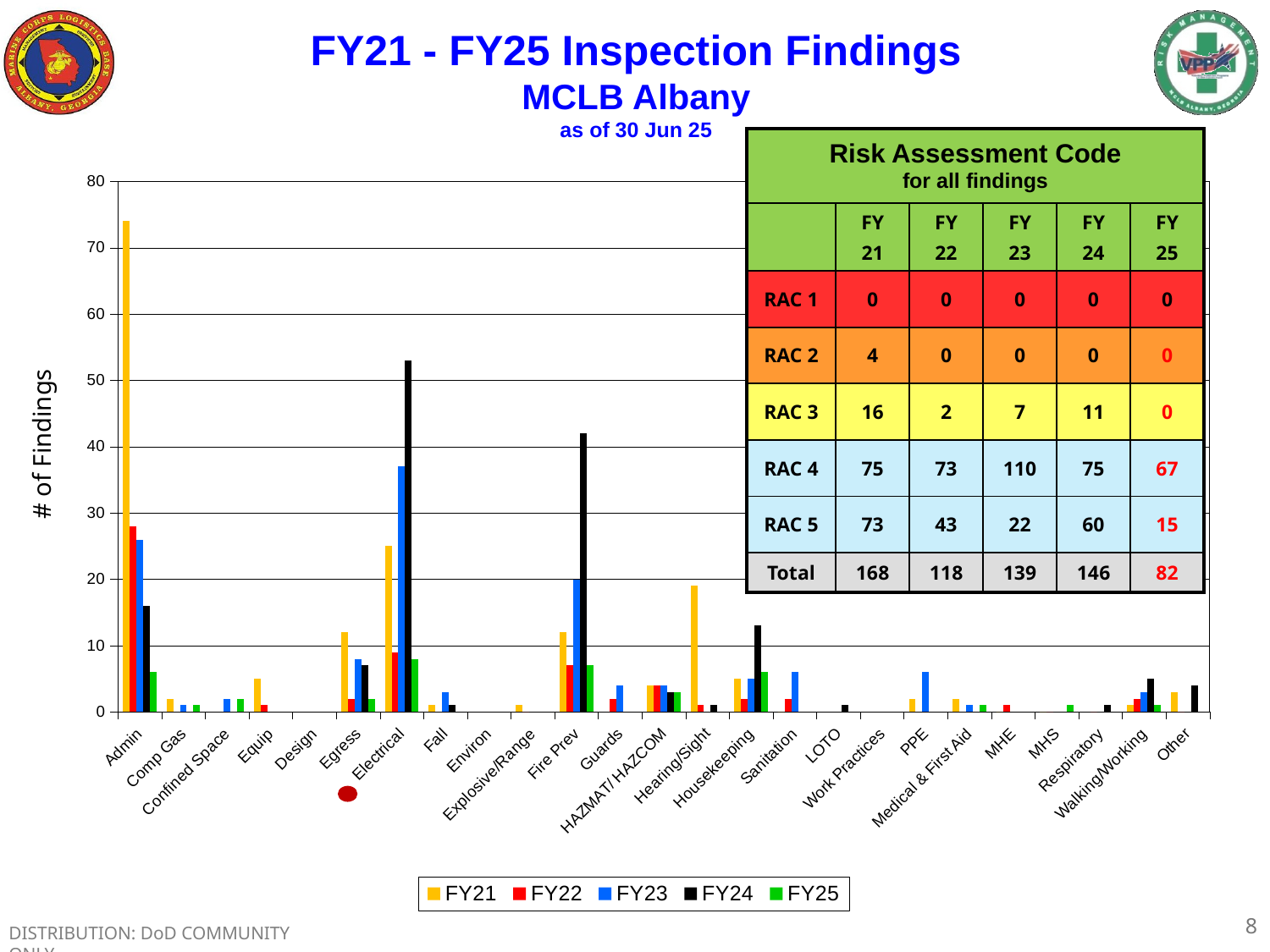
Which category has the highest FY24 value? Electrical What kind of chart is shown on the slide? bar chart Is the FY21 value for Admin greater or less than 70? greater Which category has the highest FY23 value? Electrical How many series does the chart legend list? 5 Is the FY24 value for Electrical greater or less than 50? greater What is the title of the chart's y axis? # of Findings How many categories are shown along the x axis of the chart? 25 Is the FY24 value for Fire Prev greater or less than 30? greater Which is larger for Electrical, the FY23 value or the FY24 value? FY24 Which category has the tallest bar in the chart? Admin